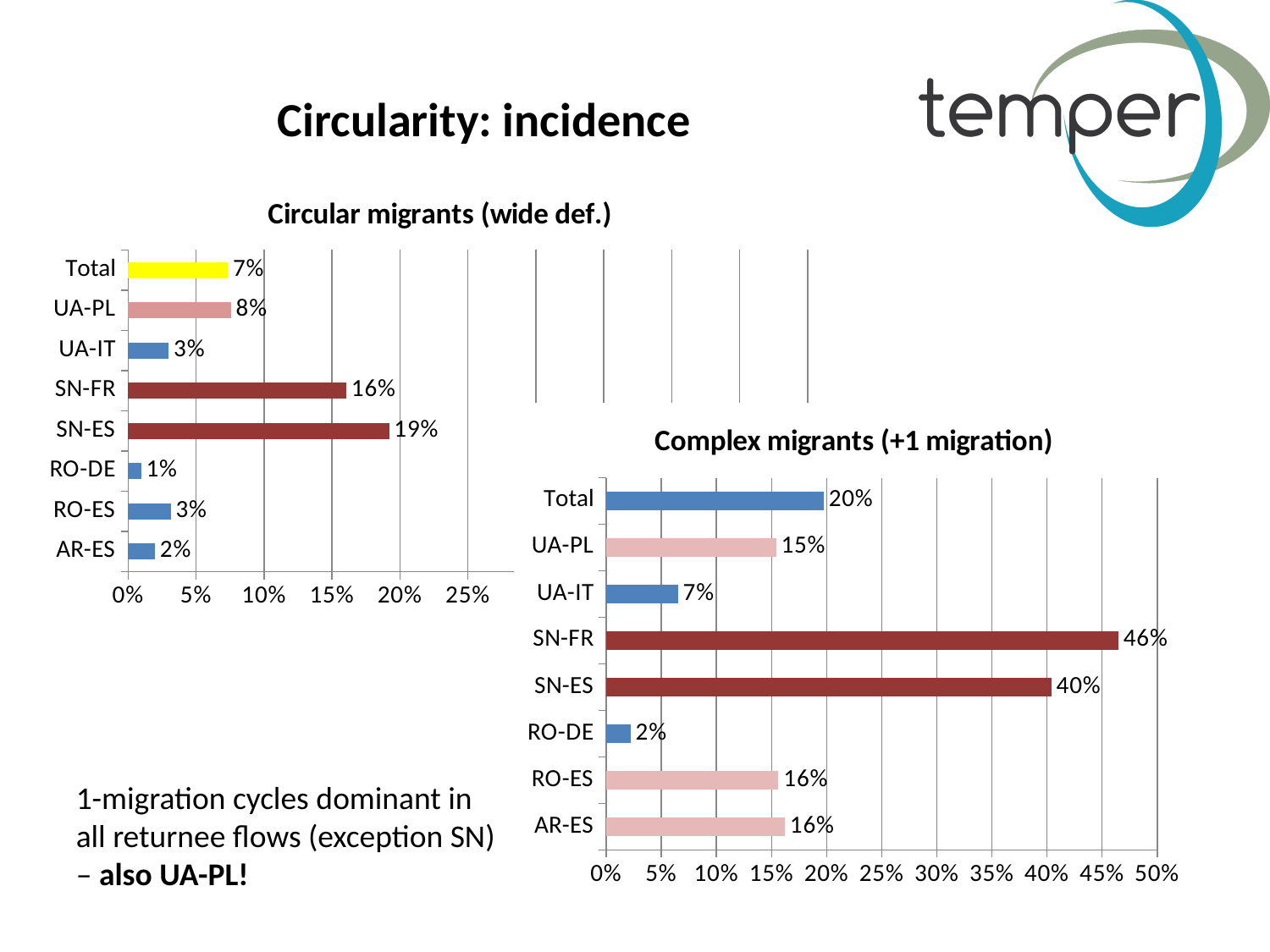
In the 'Circular migrants (wide def.)' chart, what is the difference between SN-ES and SN-FR? 3% In the 'Complex migrants (+1 migration)' chart, what is the value for Total? 20% How many categories are shown in the 'Complex migrants (+1 migration)' chart? 8 In the 'Circular migrants (wide def.)' chart, what is the value for UA-PL? 8% In the 'Circular migrants (wide def.)' chart, what is the value for SN-ES? 19% What type of chart is the 'Circular migrants (wide def.)' chart? Bar chart In the 'Complex migrants (+1 migration)' chart, which category has the highest value? SN-FR In the 'Circular migrants (wide def.)' chart, which category has the highest value? SN-ES In the 'Complex migrants (+1 migration)' chart, what is the difference between SN-FR and SN-ES? 6% In the 'Circular migrants (wide def.)' chart, which category has the lowest value? RO-DE In the 'Complex migrants (+1 migration)' chart, which is larger, UA-PL or UA-IT? UA-PL In the 'Complex migrants (+1 migration)' chart, what is the value for SN-FR? 46%